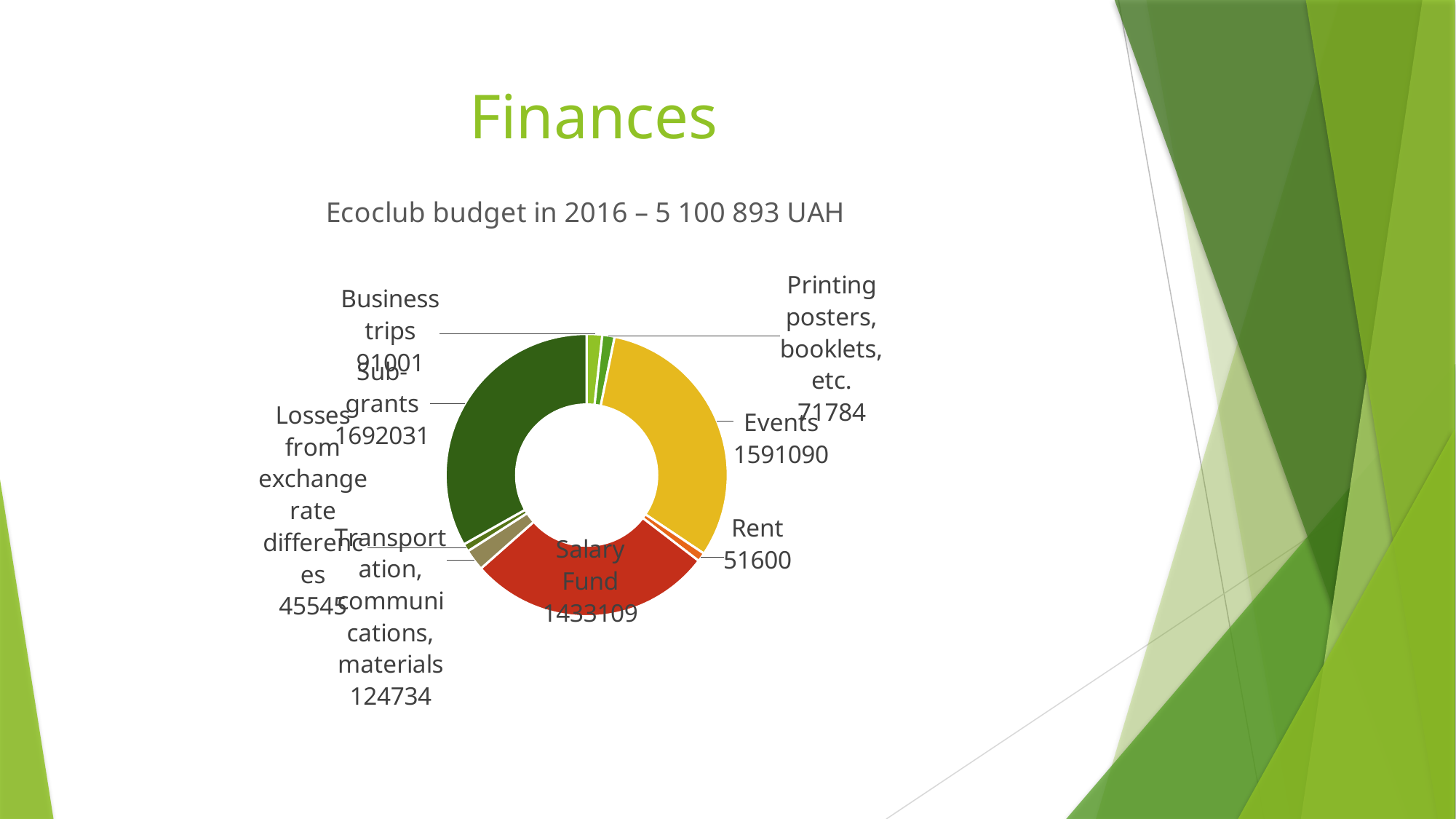
What kind of chart is shown on the slide? doughnut chart What is the difference between the values for Events and Salary Fund? 157981 How many categories are shown in the chart? 8 What is the value for Rent? 51600 Which category has the smallest value? Losses from exchange rate differences Which category has the largest value? Sub-grants What is the value for Sub-grants? 1692031 What is the difference between the values for Sub-grants and Events? 100941 What is the value for Events? 1591090 What is the value for Business trips? 91001 What is the value for Salary Fund? 1433109 Which is larger, Business trips or Printing posters, booklets, etc.? Business trips